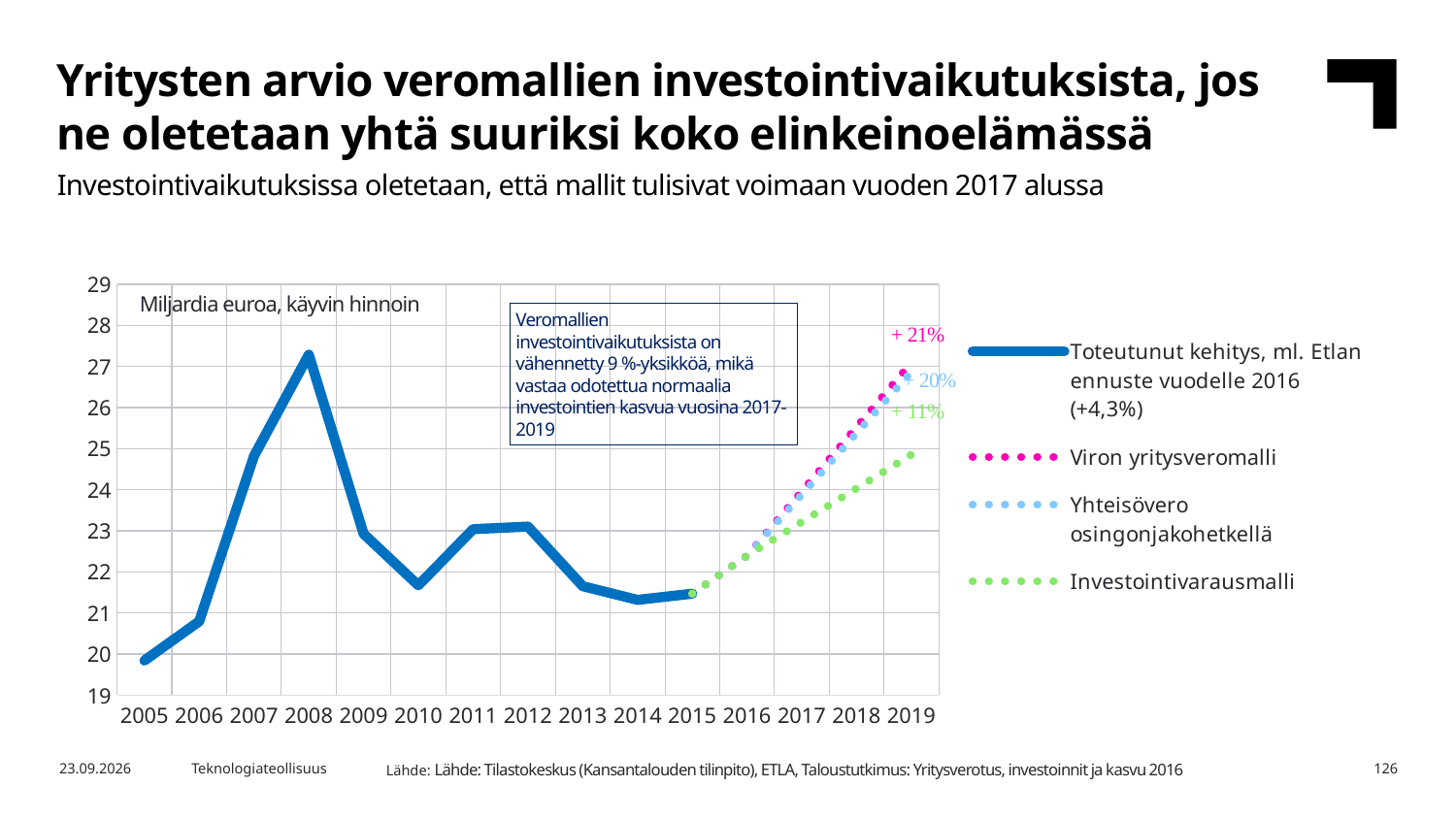
Which is larger for the solid blue line: the value in 2008 or the value in 2011? 2008 Is the 2019 value of the Viron yritysveromalli series greater or less than 26? greater What percentage label is shown at the end of the Investointivarausmalli series? + 11% In which year does the solid blue line (Toteutunut kehitys) reach its highest value? 2008 Does the solid blue line rise or fall between 2008 and 2010? Fall Is the value of the solid blue line in 2008 greater or less than 26? greater Is the value of the solid blue line in 2015 greater or less than 22? less How many series does the legend list? 4 What kind of chart is shown on the slide? Line chart In which year is the solid blue line (Toteutunut kehitys) at its lowest value? 2005 Which series has the higher value in 2019: Viron yritysveromalli or Investointivarausmalli? Viron yritysveromalli How many years are shown on the x axis? 15